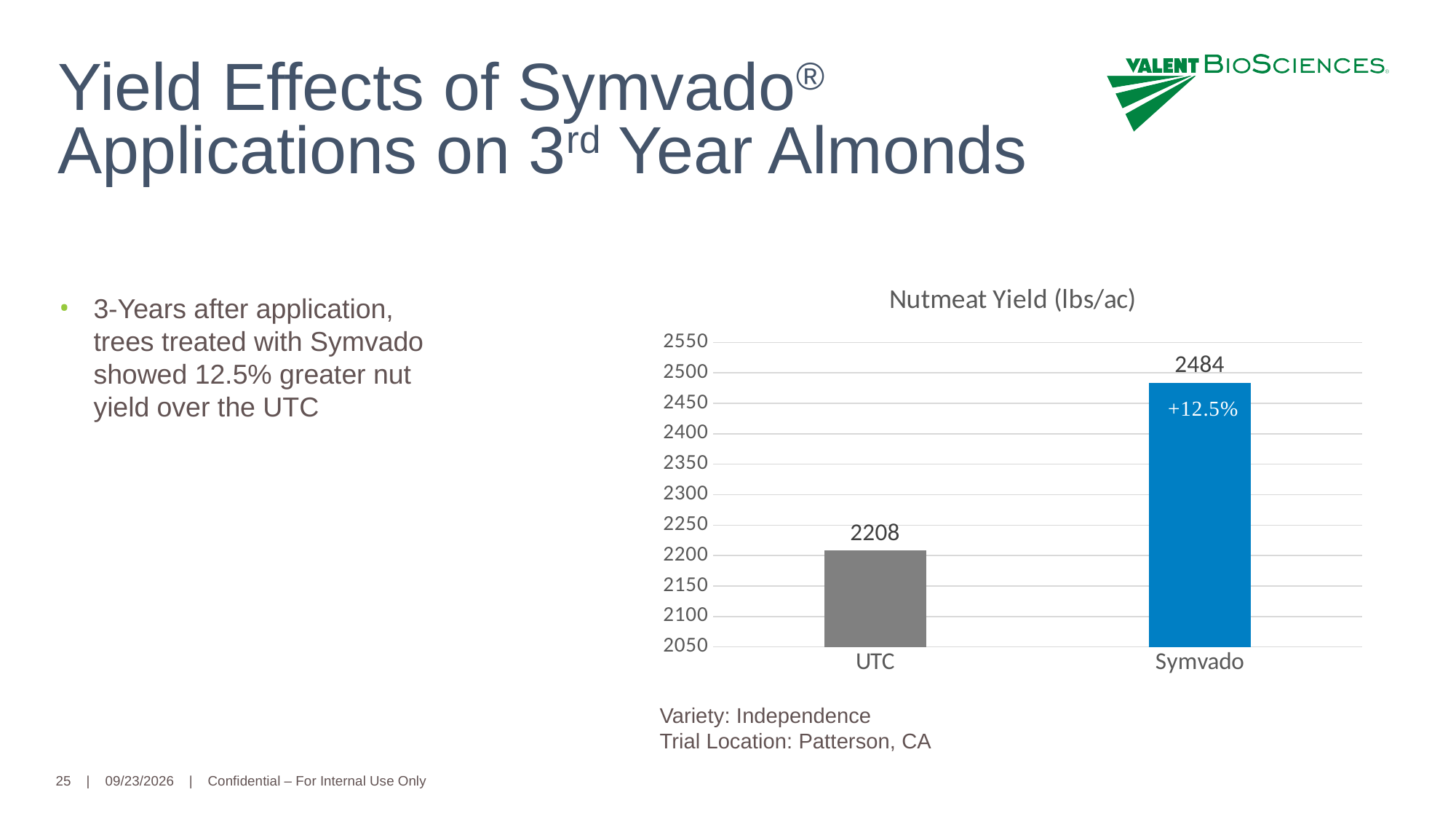
Which has a larger nutmeat yield, UTC or Symvado? Symvado Which category has the lowest nutmeat yield? UTC What is the nutmeat yield for Symvado? 2484 What is the title of the chart? Nutmeat Yield (lbs/ac) What is the difference in nutmeat yield between Symvado and UTC? 276 What percentage increase is labelled on the Symvado bar? +12.5% Is the value for UTC greater or less than 2250? less What kind of chart is shown on the slide? bar chart How many categories are shown on the chart? 2 Is the value for Symvado greater or less than 2450? greater Which category has the highest nutmeat yield? Symvado What is the nutmeat yield for UTC? 2208